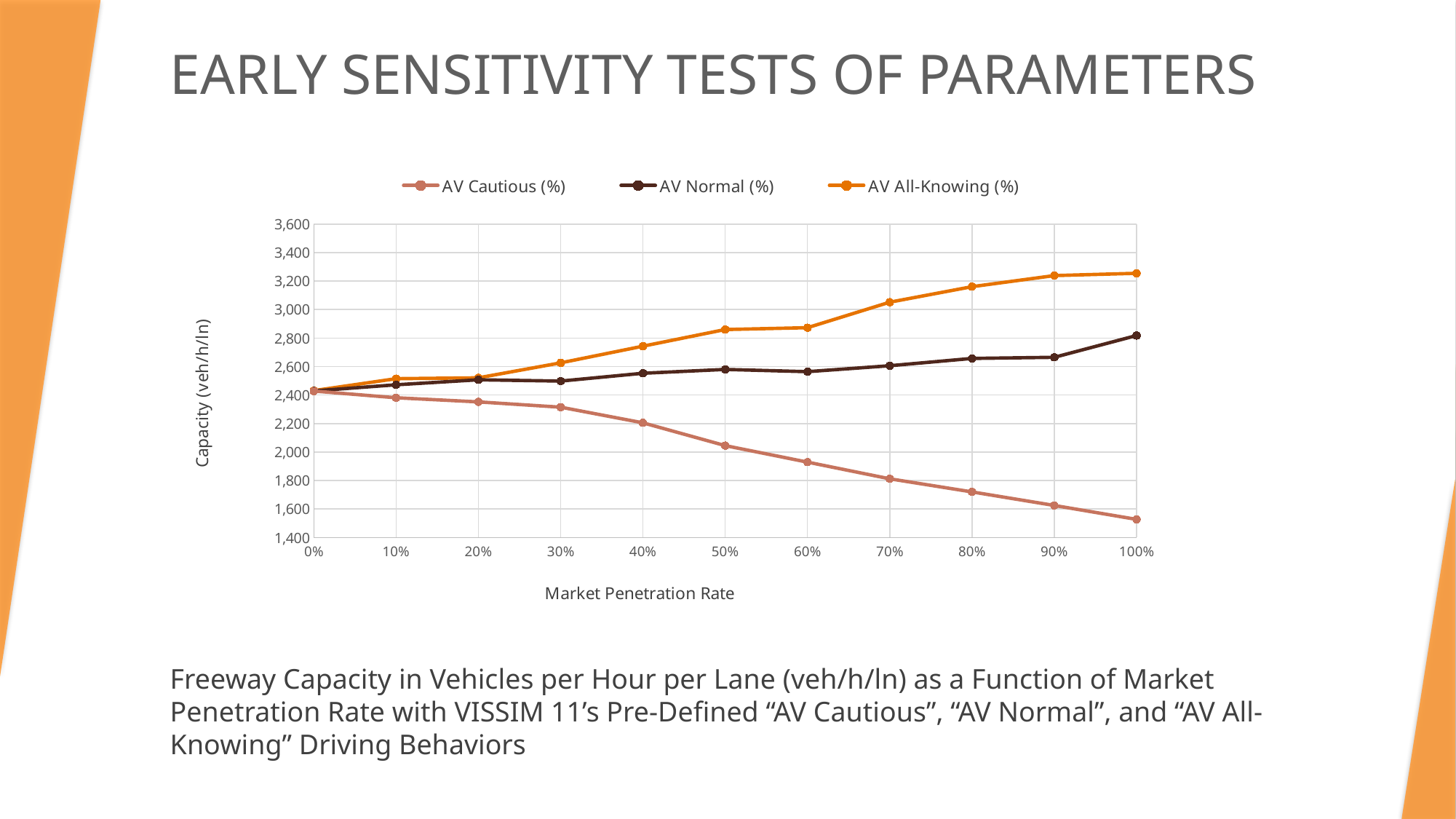
Is the AV Cautious (%) capacity at 60% market penetration greater or less than 2,000? less Is the AV Normal (%) capacity at 100% market penetration greater or less than 2,600? greater Does the AV Cautious (%) series rise or fall as the market penetration rate increases? fall Does the AV All-Knowing (%) series rise or fall as the market penetration rate increases? rise Which series has the highest capacity at 100% market penetration? AV All-Knowing (%) What is the label of the y axis? Capacity (veh/h/ln) How many market penetration rate points are plotted along the x axis? 11 How many series does the legend list? 3 Is the AV Cautious (%) capacity at 100% market penetration greater or less than 1,600? less What kind of chart is shown on the slide? line chart At 50% market penetration, which is higher: AV All-Knowing (%) or AV Normal (%)? AV All-Knowing (%)